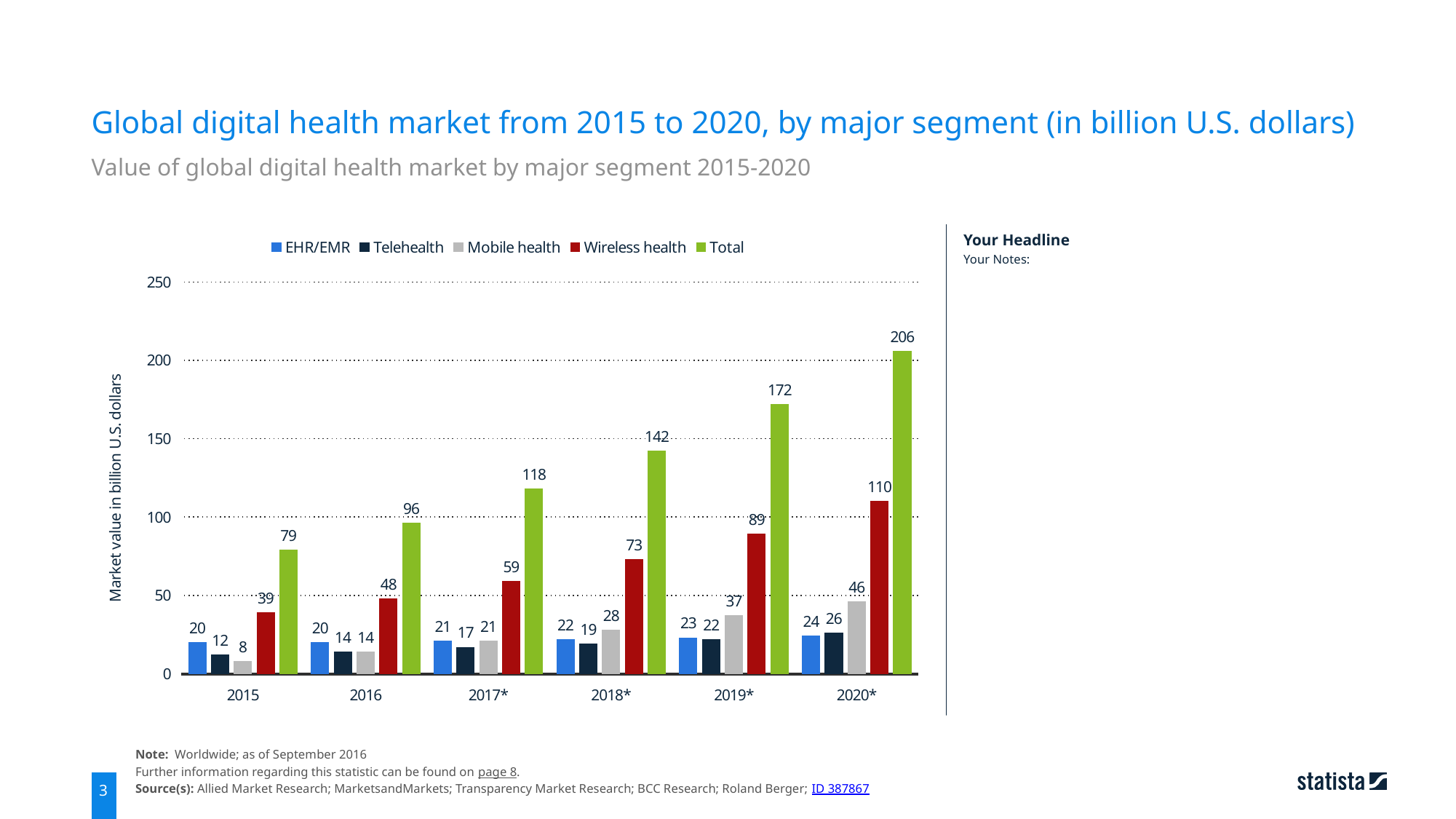
Which is larger in 2017*: Telehealth or Mobile health? Mobile health What is the Wireless health value for 2018*? 73 What is the Mobile health value for 2015? 8 What is the Telehealth value for 2019*? 22 How many series does the legend list? 5 What kind of chart is shown on the slide? Bar chart Which year has the highest Total value? 2020* Does the Total value rise or fall from 2015 to 2020*? Rise Which year has the lowest Wireless health value? 2015 What is the difference between the Total values for 2020* and 2019*? 34 How many years are shown on the x axis? 6 What is the Total value for 2020*? 206